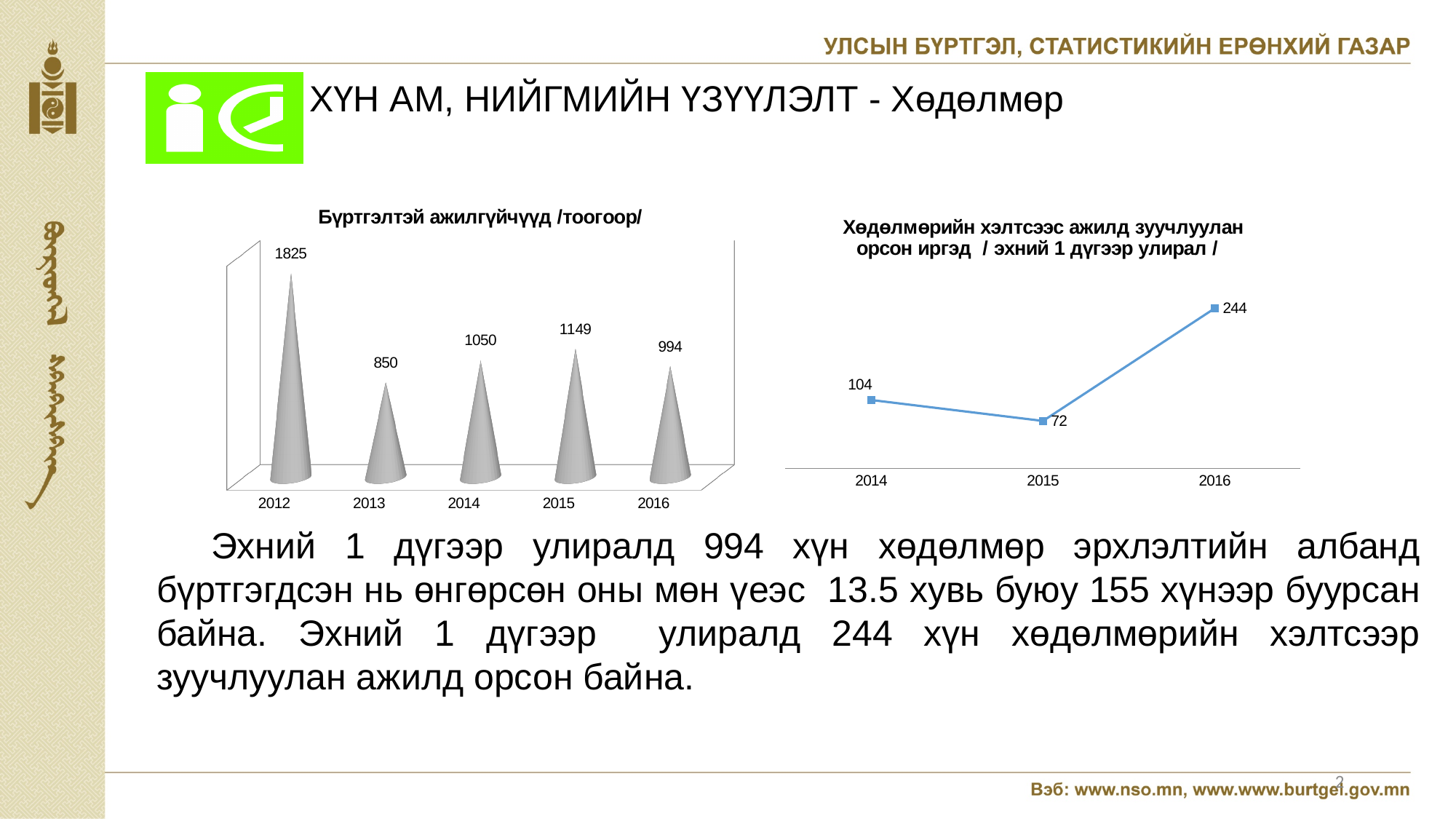
In the right chart 'Хөдөлмөрийн хэлтсээс ажилд зуучлуулан орсон иргэд', which year has the highest value? 2016 How many years are shown in the left chart 'Бүртгэлтэй ажилгүйчүүд /тоогоор/'? 5 In the left chart 'Бүртгэлтэй ажилгүйчүүд /тоогоор/', what is the difference between the values for 2015 and 2016? 155 In the left chart 'Бүртгэлтэй ажилгүйчүүд /тоогоор/', which year has the lowest value? 2013 What kind of chart is the right chart 'Хөдөлмөрийн хэлтсээс ажилд зуучлуулан орсон иргэд'? Line chart In the left chart 'Бүртгэлтэй ажилгүйчүүд /тоогоор/', what is the value for 2012? 1825 What kind of chart is the left chart 'Бүртгэлтэй ажилгүйчүүд /тоогоор/'? Bar chart In the right chart 'Хөдөлмөрийн хэлтсээс ажилд зуучлуулан орсон иргэд', what is the value for 2015? 72 In the right chart 'Хөдөлмөрийн хэлтсээс ажилд зуучлуулан орсон иргэд', what is the difference between the values for 2016 and 2014? 140 In the left chart 'Бүртгэлтэй ажилгүйчүүд /тоогоор/', what is the value for 2016? 994 In the left chart 'Бүртгэлтэй ажилгүйчүүд /тоогоор/', which year has the highest value? 2012 In the left chart 'Бүртгэлтэй ажилгүйчүүд /тоогоор/', which is larger, the value for 2014 or the value for 2015? 2015